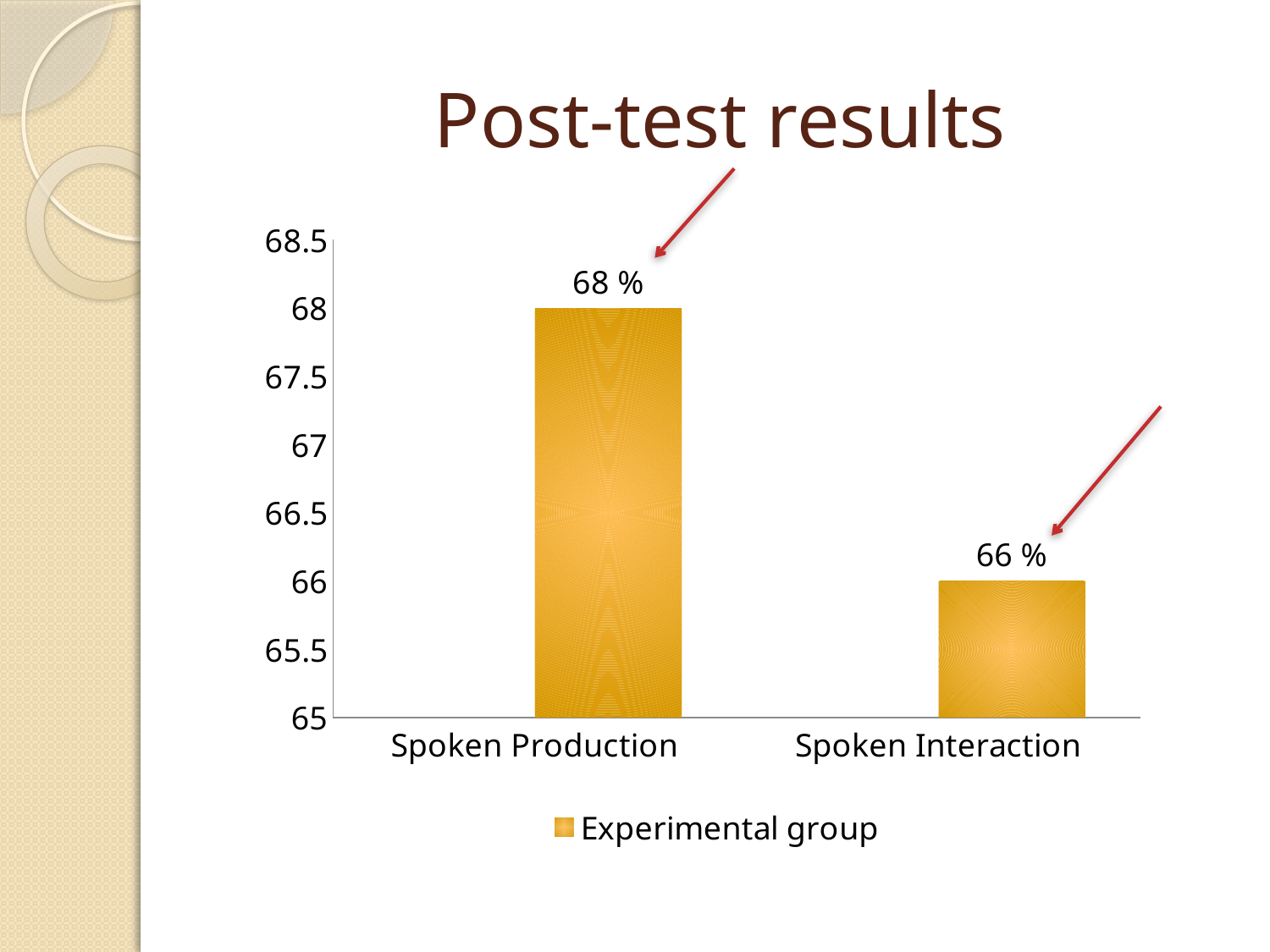
Which category has the highest value? Spoken Production What is the name of the series shown in the legend? Experimental group How many series does the legend list? 1 Is the value for Spoken Production greater or less than 67? greater Which is larger, the value for Spoken Production or the value for Spoken Interaction? Spoken Production How many categories are shown on the x axis? 2 What kind of chart is shown on the slide? bar chart What is the difference between the values for Spoken Production and Spoken Interaction? 2 % What is the value for Spoken Interaction? 66 % Which category has the lowest value? Spoken Interaction What is the value for Spoken Production? 68 % Is the value for Spoken Interaction greater or less than 67? less